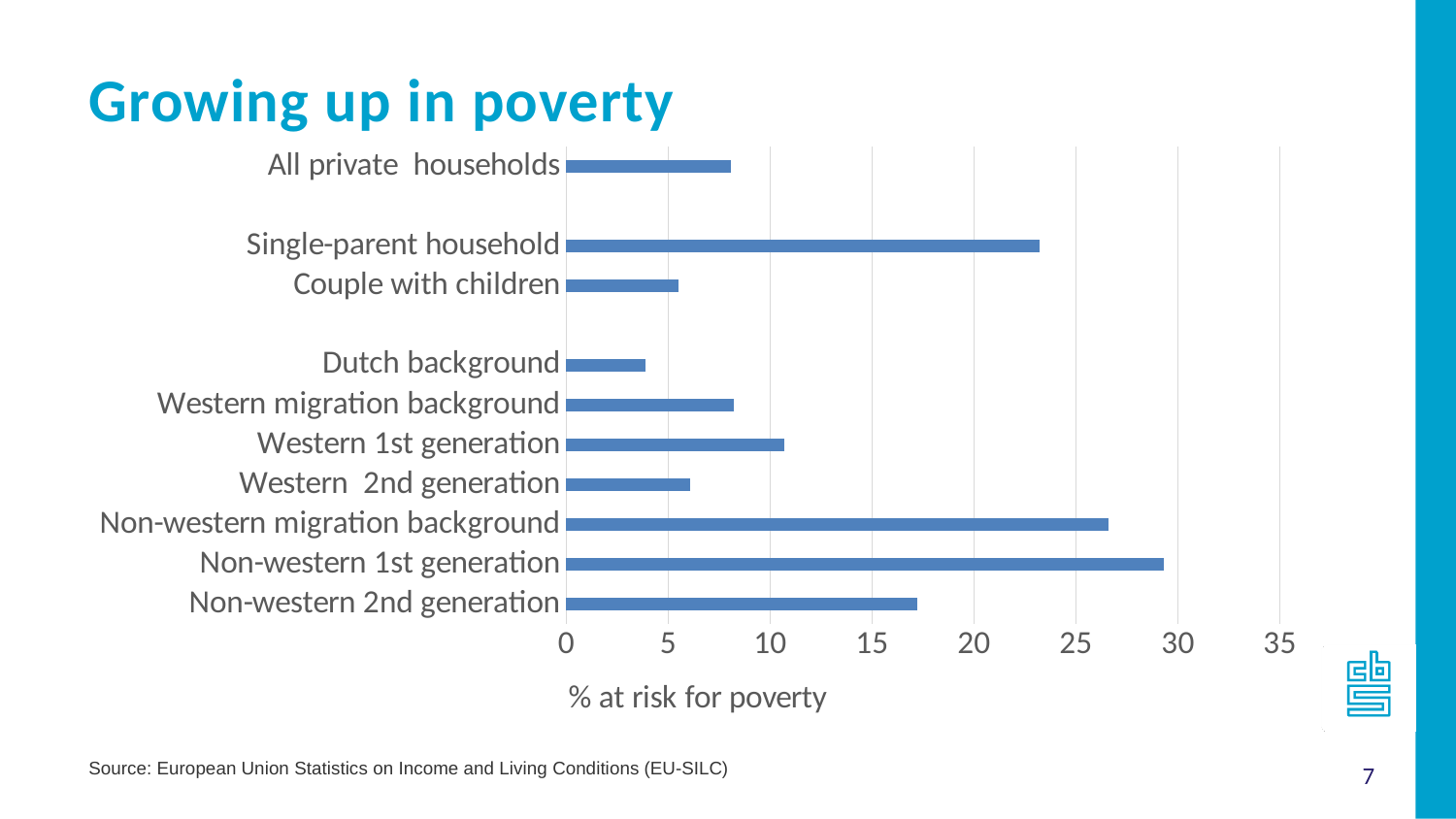
Which is larger, the value for Western 2nd generation or the value for Non-western 2nd generation? Non-western 2nd generation What is the label of the horizontal axis? % at risk for poverty Is the value for Non-western migration background greater or less than 25? greater How many categories are plotted in the chart? 10 Is the value for Couple with children greater or less than 10? less Is the value for Single-parent household greater or less than 20? greater What kind of chart is shown on the slide? bar chart Which category has the lowest % at risk for poverty? Dutch background Which category has the highest % at risk for poverty? Non-western 1st generation Which is larger, the value for Single-parent household or the value for Couple with children? Single-parent household